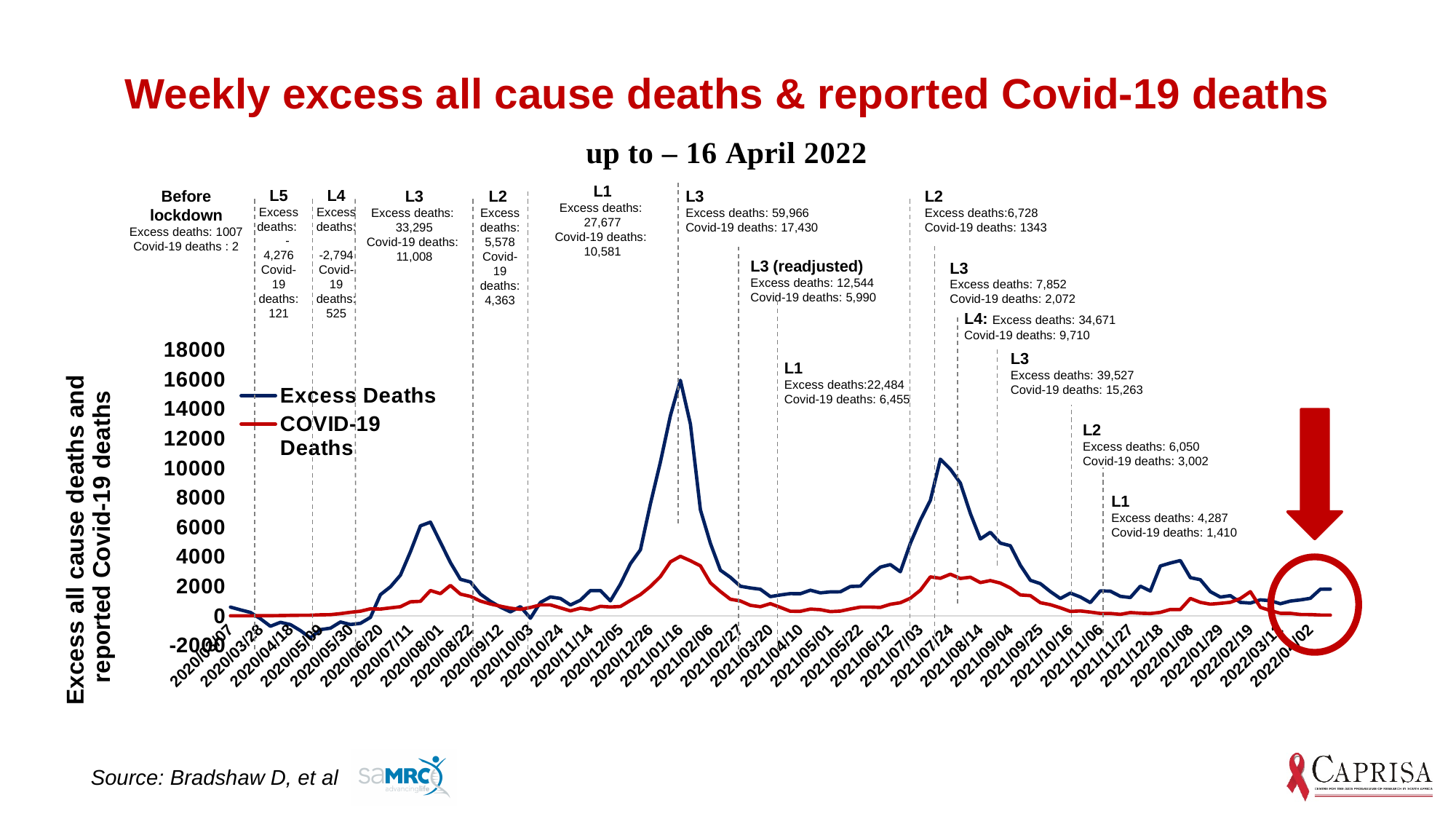
Is the peak value of the COVID-19 Deaths line around 2021/01/16 greater or less than 6000? less What are the two series named in the legend? Excess Deaths and COVID-19 Deaths According to the annotation, how many excess deaths were there before lockdown? 1007 Which series reaches the highest value on the chart? Excess Deaths What kind of chart is shown on the slide? line chart Is the Excess Deaths value around 2021/07/24 greater or less than 8000? greater What is the title of the chart? Weekly excess all cause deaths & reported Covid-19 deaths According to the L4 annotation on the right side of the chart, how many excess deaths were there? 34,671 How many series does the legend list? 2 According to the annotation, how many Covid-19 deaths were there before lockdown? 2 According to the L3 (readjusted) annotation, how many Covid-19 deaths were there? 5,990 Is the peak value of the Excess Deaths line around 2021/01/16 greater or less than 14000? greater